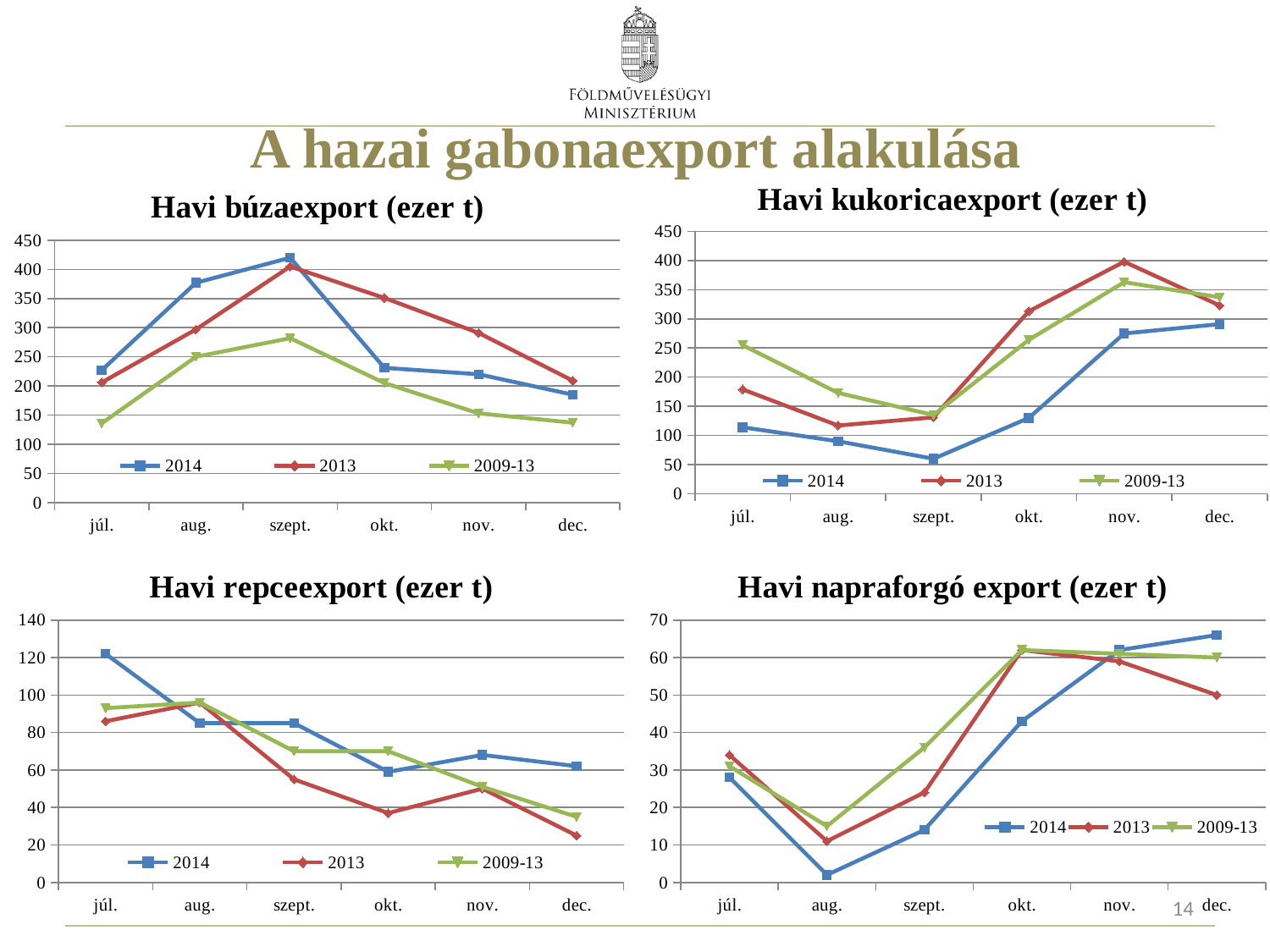
In the "Havi kukoricaexport (ezer t)" chart, which month has the highest value for 2013? nov. What kind of chart is the "Havi búzaexport (ezer t)" chart? line chart In the "Havi kukoricaexport (ezer t)" chart, do the 2014 values rise or fall from szept. to dec.? rise In the "Havi repceexport (ezer t)" chart, which month has the lowest value for 2013? dec. In the "Havi búzaexport (ezer t)" chart, is the 2014 value for szept. greater or less than 400? greater In the "Havi búzaexport (ezer t)" chart, which month has the highest value for 2014? szept. In the "Havi napraforgó export (ezer t)" chart, which month has the lowest value for 2014? aug. In the "Havi napraforgó export (ezer t)" chart, is the 2014 value for aug. greater or less than 10? less In the "Havi kukoricaexport (ezer t)" chart, is the 2014 value for szept. greater or less than 100? less How many months are shown on the x axis of the "Havi kukoricaexport (ezer t)" chart? 6 How many series does the legend of the "Havi búzaexport (ezer t)" chart list? 3 In the "Havi repceexport (ezer t)" chart, which series has the larger value in júl., 2014 or 2013? 2014